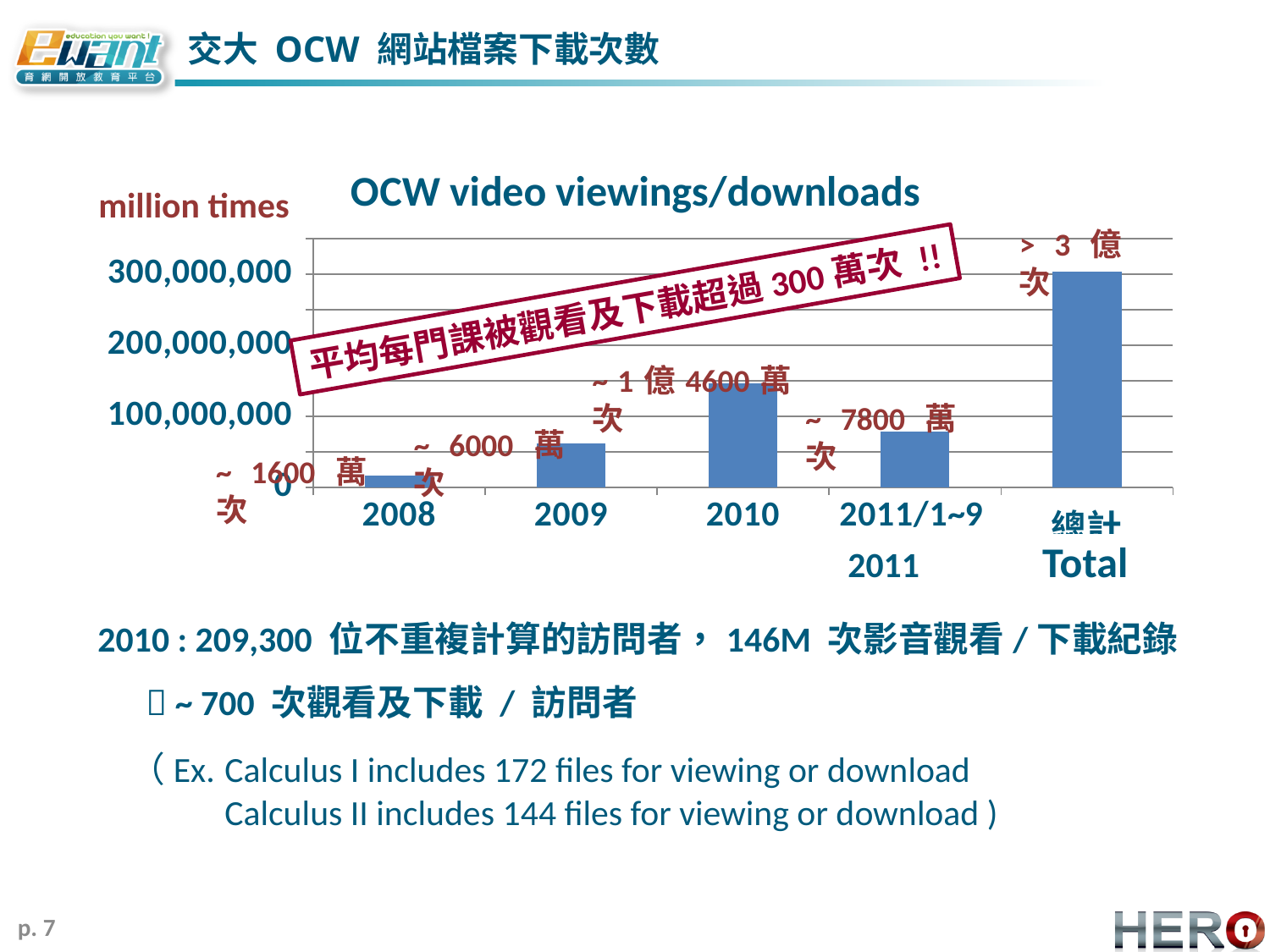
Which category has the tallest bar in the chart? 總計 Total What kind of chart is shown on the slide? bar chart Is the value for 2010 greater or less than 100,000,000? greater Which category has the shortest bar in the chart? 2008 Which is larger, the value for 2009 or the value for 2010? 2010 Among the individual years (excluding the total), which year has the highest value? 2010 Is the value for 總計 Total greater or less than 200,000,000? greater Is the value for 2008 greater or less than 100,000,000? less How many bars are plotted in the chart? 5 What is the title of the chart? OCW video viewings/downloads What unit label is shown above the y axis of the chart? million times Do the values rise or fall from 2008 to 2010? rise